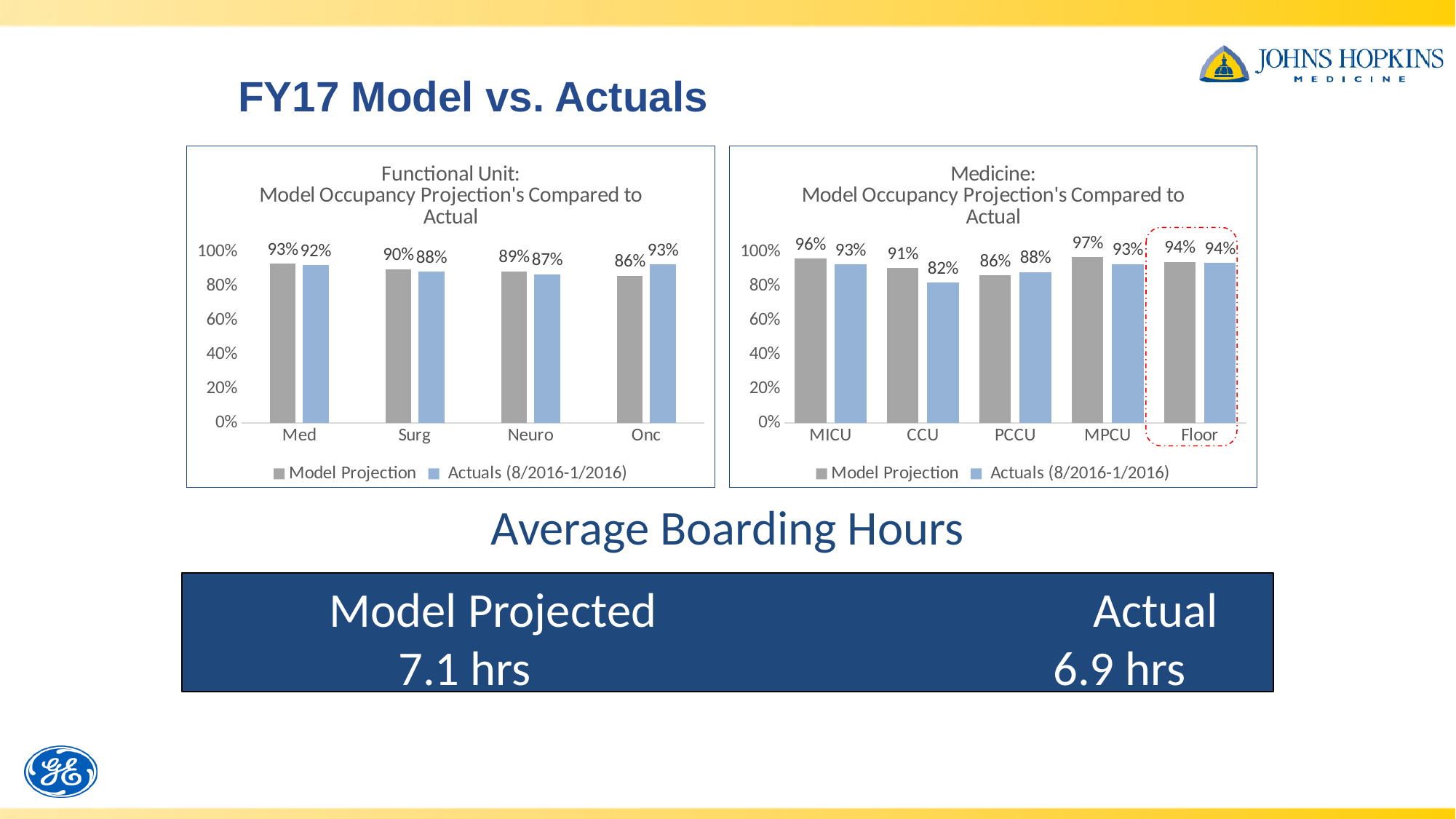
What type of chart is the Functional Unit chart? Bar chart In the Medicine chart, which category has the lowest Actuals (8/2016-1/2016) value? CCU In the Functional Unit chart, how many categories are shown on the x axis? 4 In the Medicine chart, which category is outlined with a red dashed box? Floor In the Functional Unit chart, what is the Model Projection value for Med? 93% In the Medicine chart, how many series does the legend list? 2 In the Medicine chart, what is the difference between the Model Projection and Actuals values for CCU? 9% In the Medicine chart, how many categories are shown on the x axis? 5 In the Medicine chart, what is the Actuals (8/2016-1/2016) value for CCU? 82% In the Medicine chart, which category has the highest Model Projection value? MPCU In the Functional Unit chart, what is the Actuals (8/2016-1/2016) value for Onc? 93% In the Functional Unit chart, which is larger for Onc: the Model Projection or the Actuals value? Actuals (8/2016-1/2016)